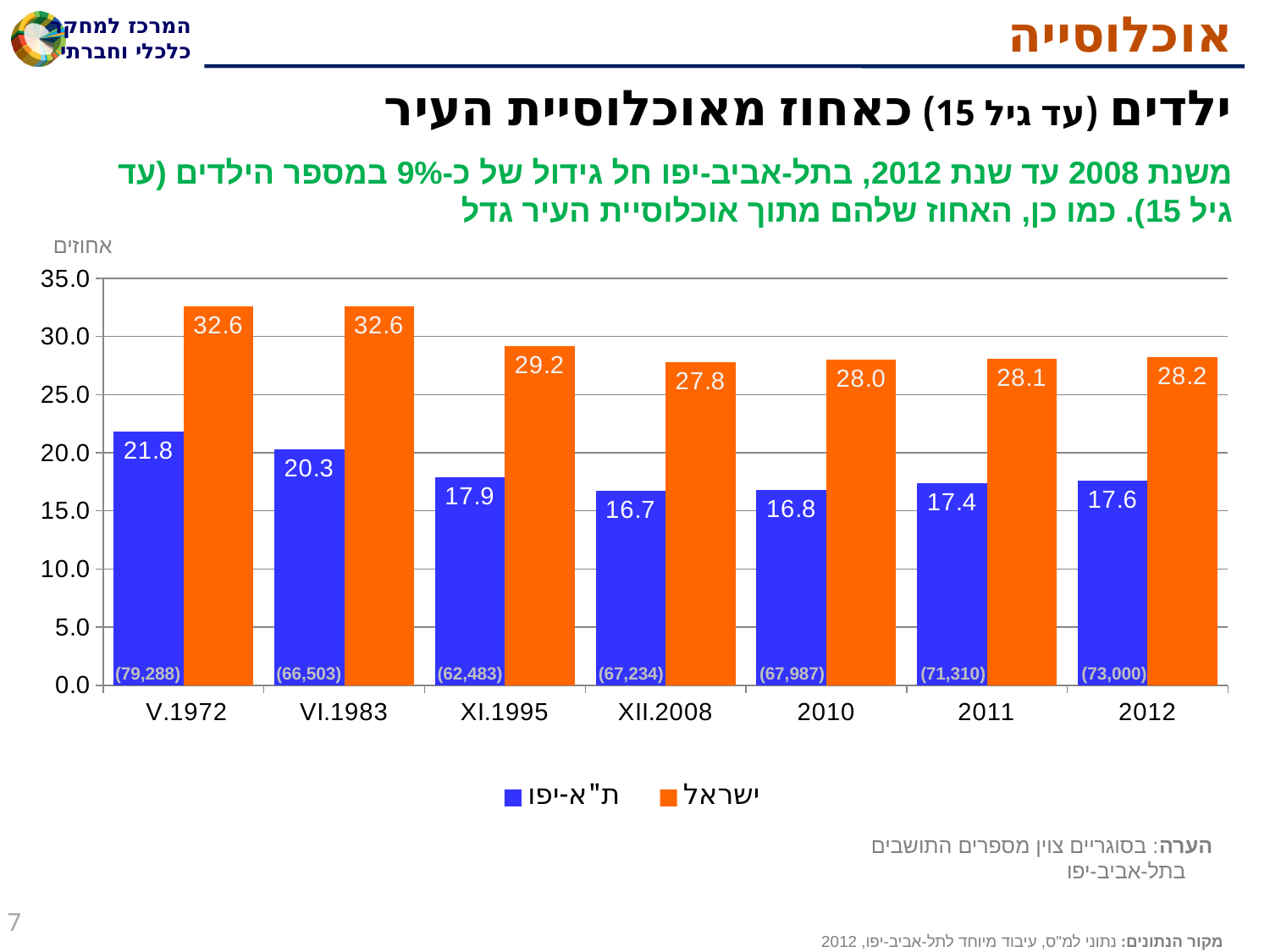
What kind of chart is shown on the slide? bar chart How many categories are shown on the x axis? 7 Is the value for ישראל in 2012 greater or less than 25.0? greater What is the value for ישראל in XI.1995? 29.2 In which category is the ת"א-יפו value highest? V.1972 What is the difference between the ישראל and ת"א-יפו values in 2010? 11.2 What is the value for ת"א-יפו in 2012? 17.6 What is the value for ת"א-יפו in XII.2008? 16.7 In which category is the ת"א-יפו value lowest? XII.2008 How many series does the legend list? 2 Which is larger in VI.1983, the ת"א-יפו value or the ישראל value? ישראל What number is shown in parentheses at the base of the ת"א-יפו bar for 2011? (71,310)